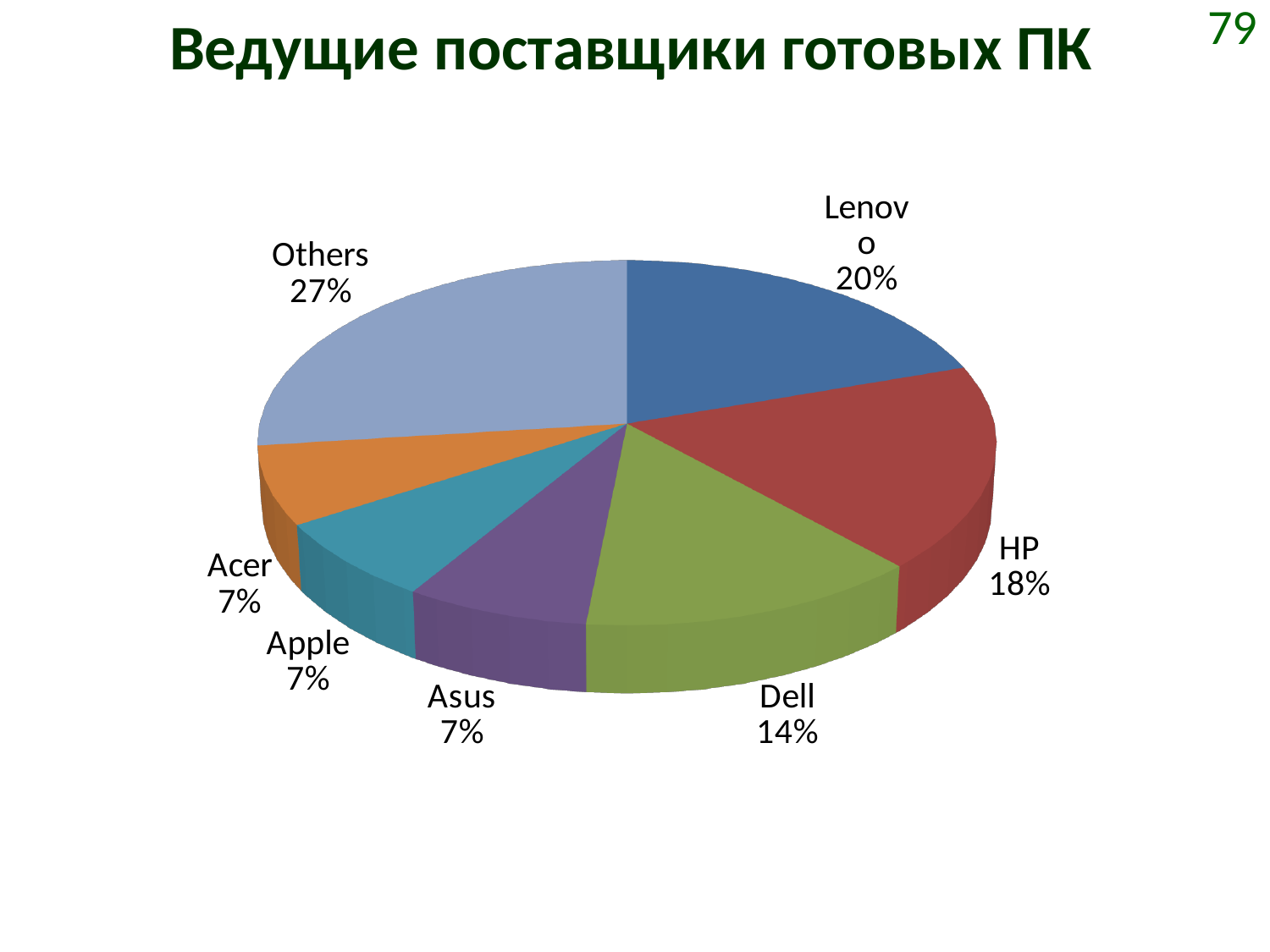
Which is larger, the share of HP or the share of Dell? HP How many slices does the pie chart have? 7 What share of the pie does Lenovo hold? 20% What kind of chart is shown on the slide? Pie chart Which category has the largest slice of the pie? Others What is the value shown for HP? 18% What is the difference between the shares of Lenovo and HP? 2% What is the difference between the shares of Others and Dell? 13% Which named vendor (excluding Others) has the largest share? Lenovo What is the value shown for Others? 27% What is the value shown for Dell? 14% What is the title of the slide? Ведущие поставщики готовых ПК